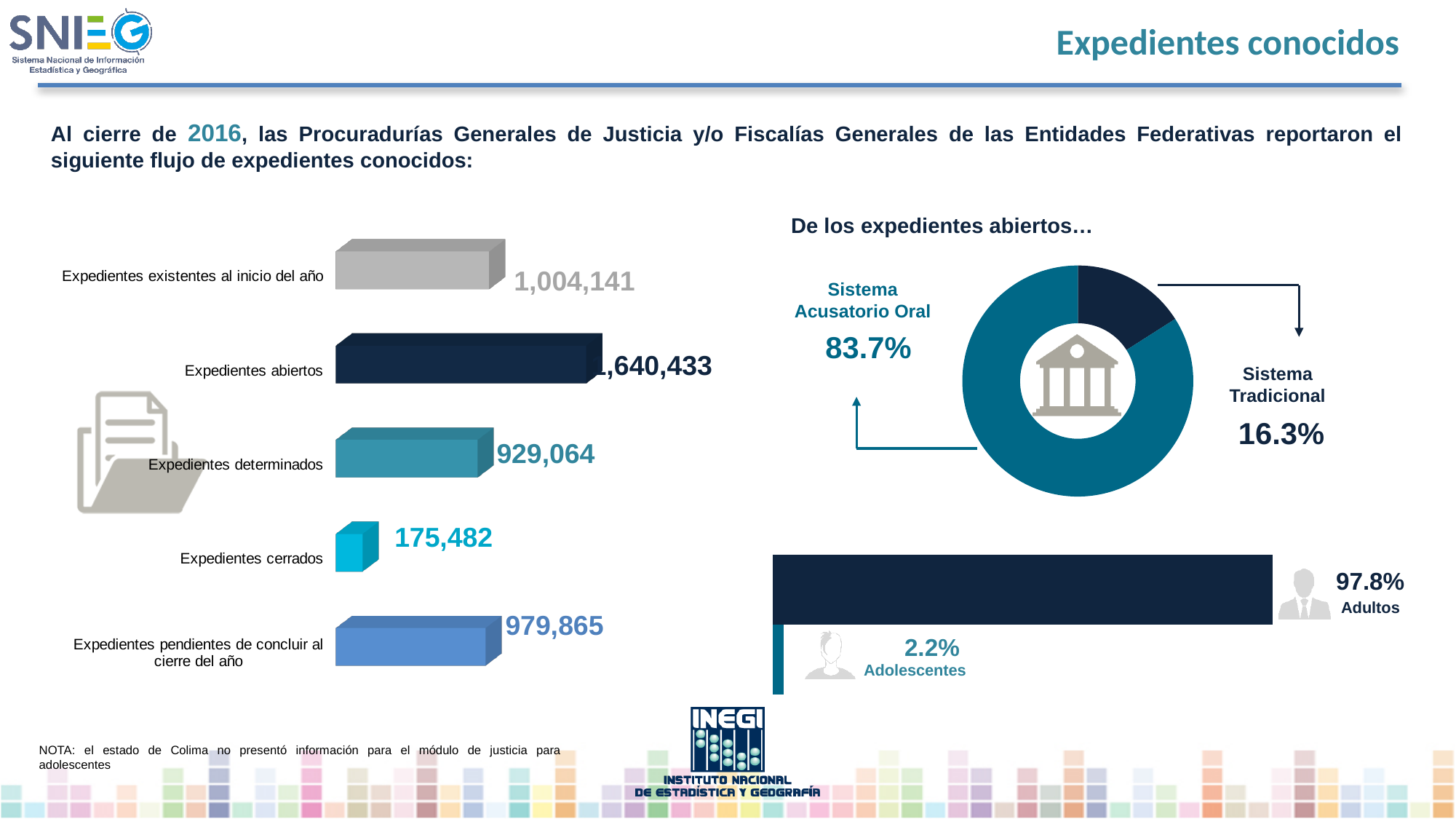
In the bar chart on the left, what is the value for Expedientes abiertos? 1,640,433 In the bar chart on the left, which category has the highest value? Expedientes abiertos How many categories does the bar chart on the left show? 5 What kind of chart is the chart on the left of the slide? Bar chart In the bar chart on the left, which category has the lowest value? Expedientes cerrados In the bar chart on the left, what is the value for Expedientes cerrados? 175,482 In the bar chart on the left, what is the difference between Expedientes existentes al inicio del año and Expedientes determinados? 75,077 In the bar chart at the bottom right, what is the value for Adolescentes? 2.2% In the donut chart titled 'De los expedientes abiertos…', which segment is larger: Sistema Acusatorio Oral or Sistema Tradicional? Sistema Acusatorio Oral In the donut chart titled 'De los expedientes abiertos…', what share corresponds to Sistema Tradicional? 16.3% In the bar chart on the left, which is larger: Expedientes determinados or Expedientes pendientes de concluir al cierre del año? Expedientes pendientes de concluir al cierre del año In the bar chart on the left, what is the value for Expedientes pendientes de concluir al cierre del año? 979,865